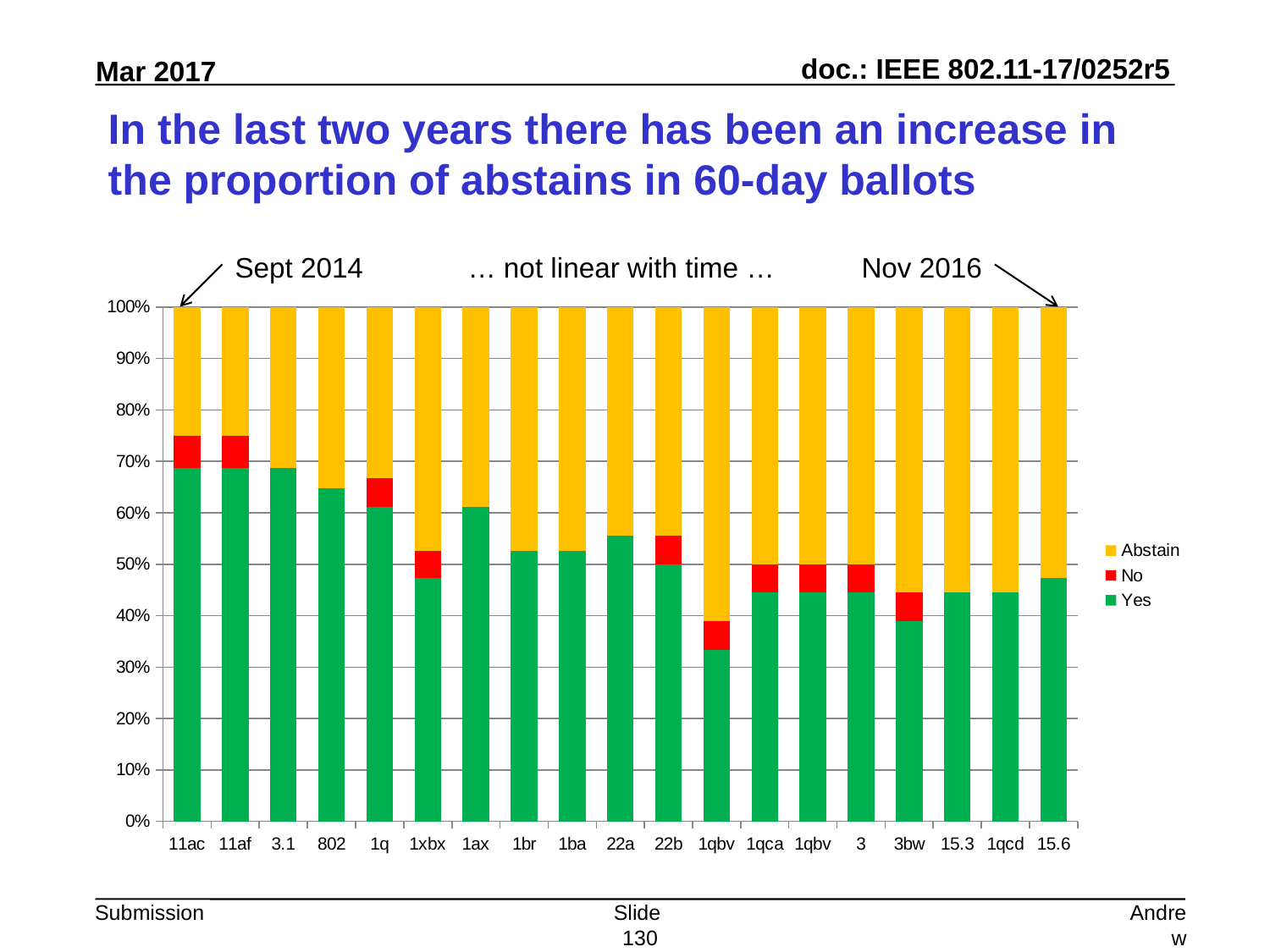
Is the Yes share for 15.6 greater or less than 50%? less Does the Yes share generally rise or fall moving from left to right along the x axis? fall Is the Yes share for 802 greater or less than 60%? greater Is the Yes share for 11ac greater or less than 60%? greater What does each stacked bar total? 100% Which colour represents the Abstain series in the legend? yellow How many series does the chart legend list? 3 Which category has the lowest Yes share? 1qbv What kind of chart is shown on the slide? stacked bar chart How many ballot categories are shown along the x axis? 19